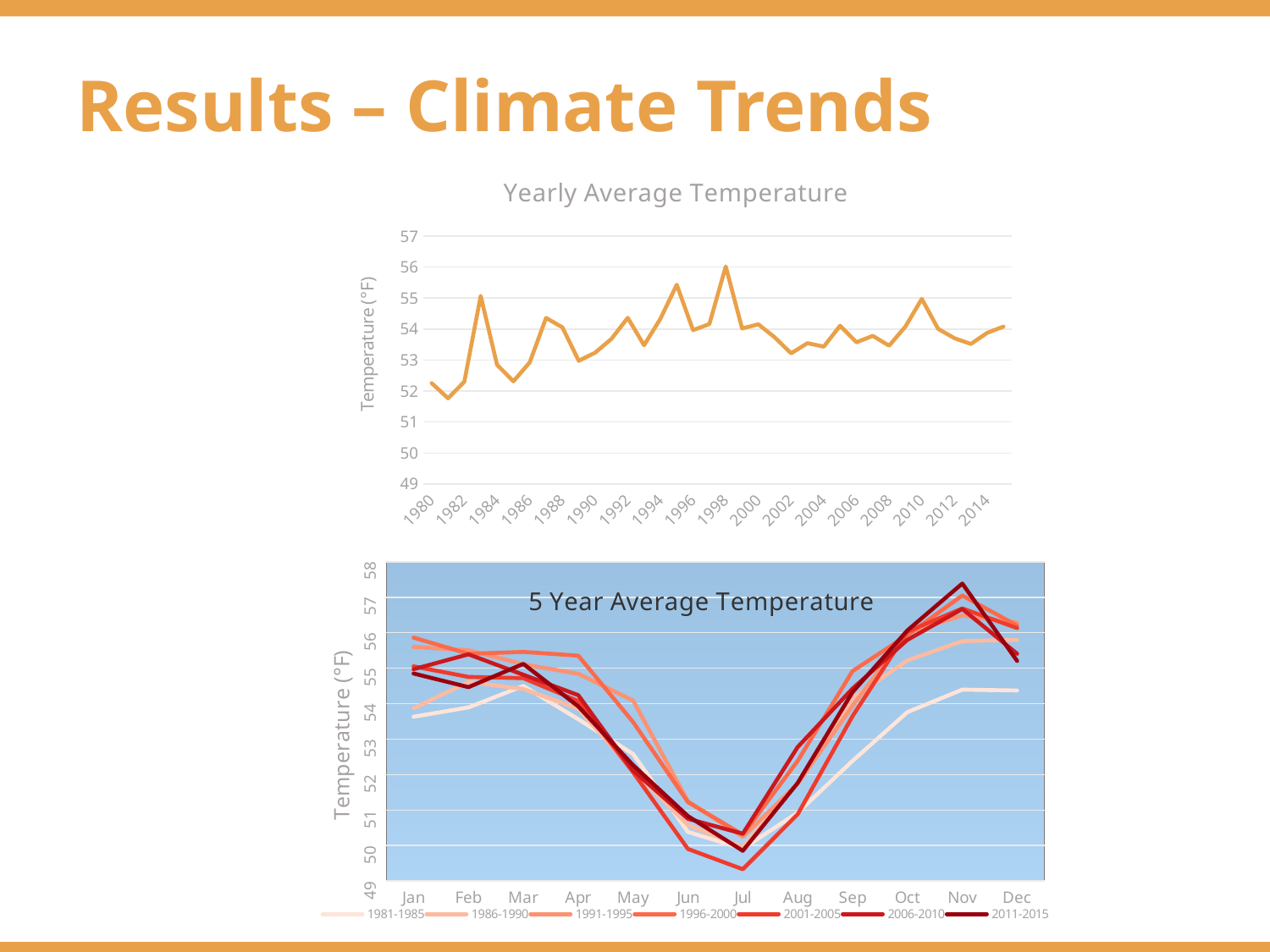
How many months are shown on the x axis of the '5 Year Average Temperature' chart? 12 In the 'Yearly Average Temperature' chart, is the value for 1998 greater or less than 55? greater How many series does the legend of the '5 Year Average Temperature' chart list? 7 In the '5 Year Average Temperature' chart, is the value for 2011-2015 in Nov greater or less than 57? greater What is the y-axis title of the 'Yearly Average Temperature' chart? Temperature (°F) In the 'Yearly Average Temperature' chart, is the value for 2002 greater or less than 54? less In the 'Yearly Average Temperature' chart, which year has the lowest temperature? 1981 In the 'Yearly Average Temperature' chart, which year has the highest temperature? 1998 What type of chart is the 'Yearly Average Temperature' chart? line chart In the '5 Year Average Temperature' chart, which month has the lowest temperature for the 2001-2005 series? Jul In the '5 Year Average Temperature' chart, which is larger in Dec: the 1981-1985 series or the 1991-1995 series? 1991-1995